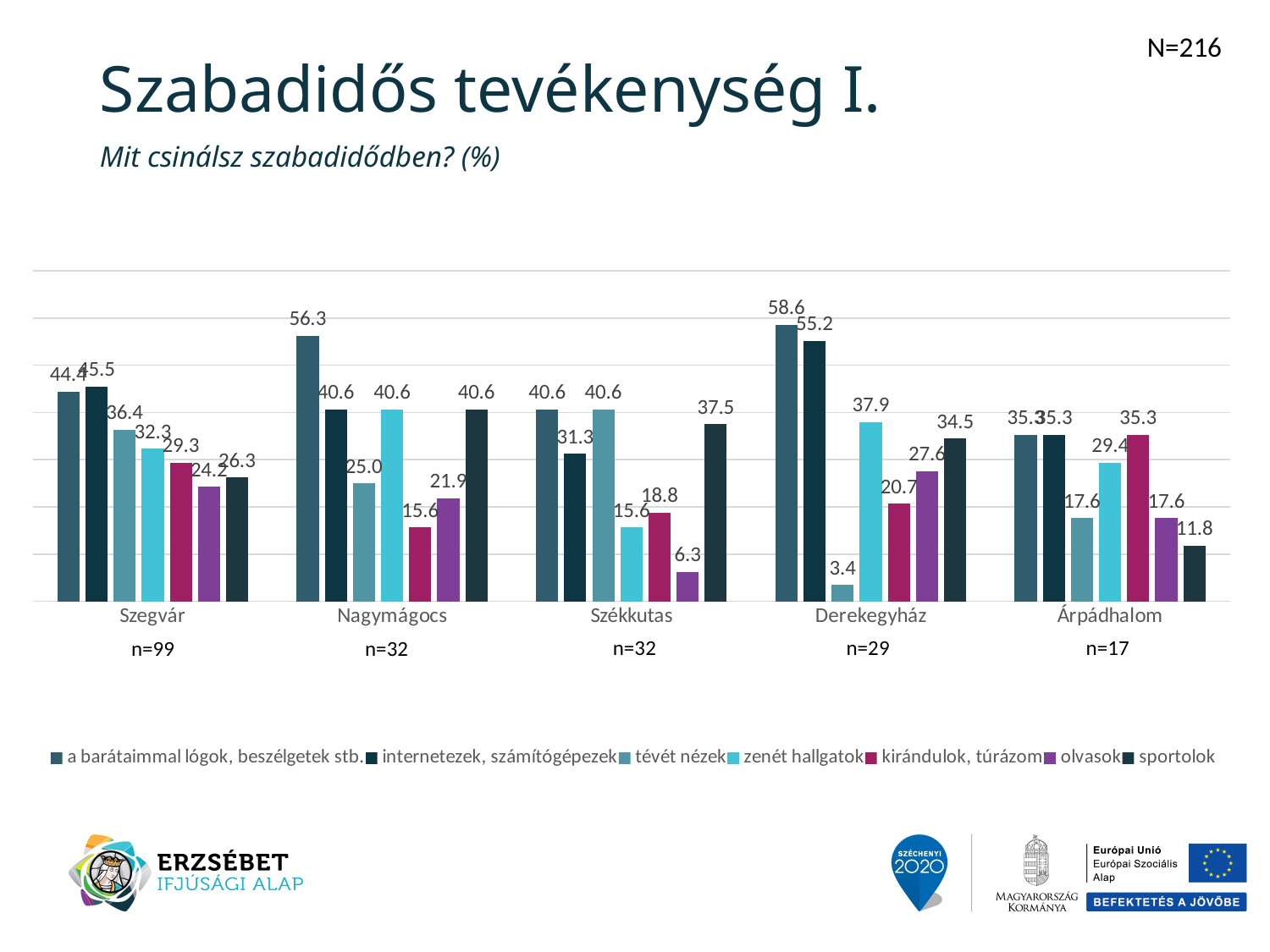
What kind of chart is shown on the slide? bar chart Which settlement has the highest value for 'a barátaimmal lógok, beszélgetek stb.'? Derekegyház How many series does the legend list? 7 In Nagymágocs, what is the difference between 'a barátaimmal lógok, beszélgetek stb.' and 'internetezek, számítógépezek'? 15.7 Which settlement has the lowest value for 'tévét nézek'? Derekegyház What is the value for 'tévét nézek' in Nagymágocs? 25.0 In Szegvár, which is larger: 'sportolok' or 'olvasok'? sportolok What is the sample size (n) shown for Szegvár? n=99 How many settlements are shown on the x axis? 5 What is the value for 'a barátaimmal lógok, beszélgetek stb.' in Derekegyház? 58.6 What is the value for 'sportolok' in Árpádhalom? 11.8 What is the value for 'olvasok' in Székkutas? 6.3